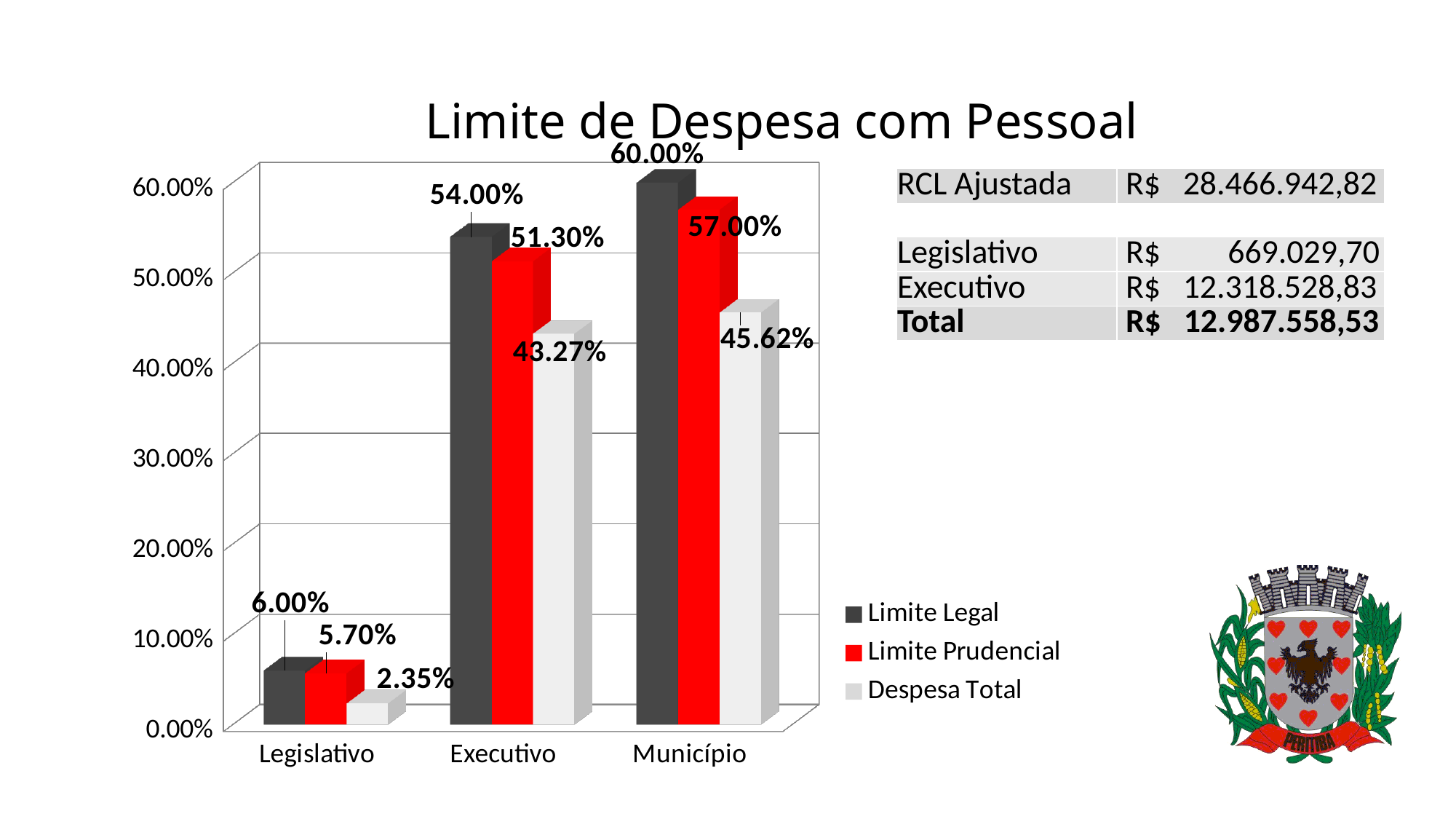
What is the Despesa Total value for Município? 45.62% What is the title of the chart? Limite de Despesa com Pessoal How many categories are shown on the x axis? 3 Is the Despesa Total value for Executivo greater or less than 40.00%? greater How many series does the legend list? 3 What is the Limite Prudencial value for Legislativo? 5.70% What is the difference between the Limite Legal and the Despesa Total for Executivo? 10.73% Which category has the lowest Despesa Total value? Legislativo What kind of chart is shown on the slide? bar chart Which is larger for Município: the Limite Prudencial or the Despesa Total? Limite Prudencial Which category has the highest Limite Legal value? Município What is the Limite Legal value for Executivo? 54.00%